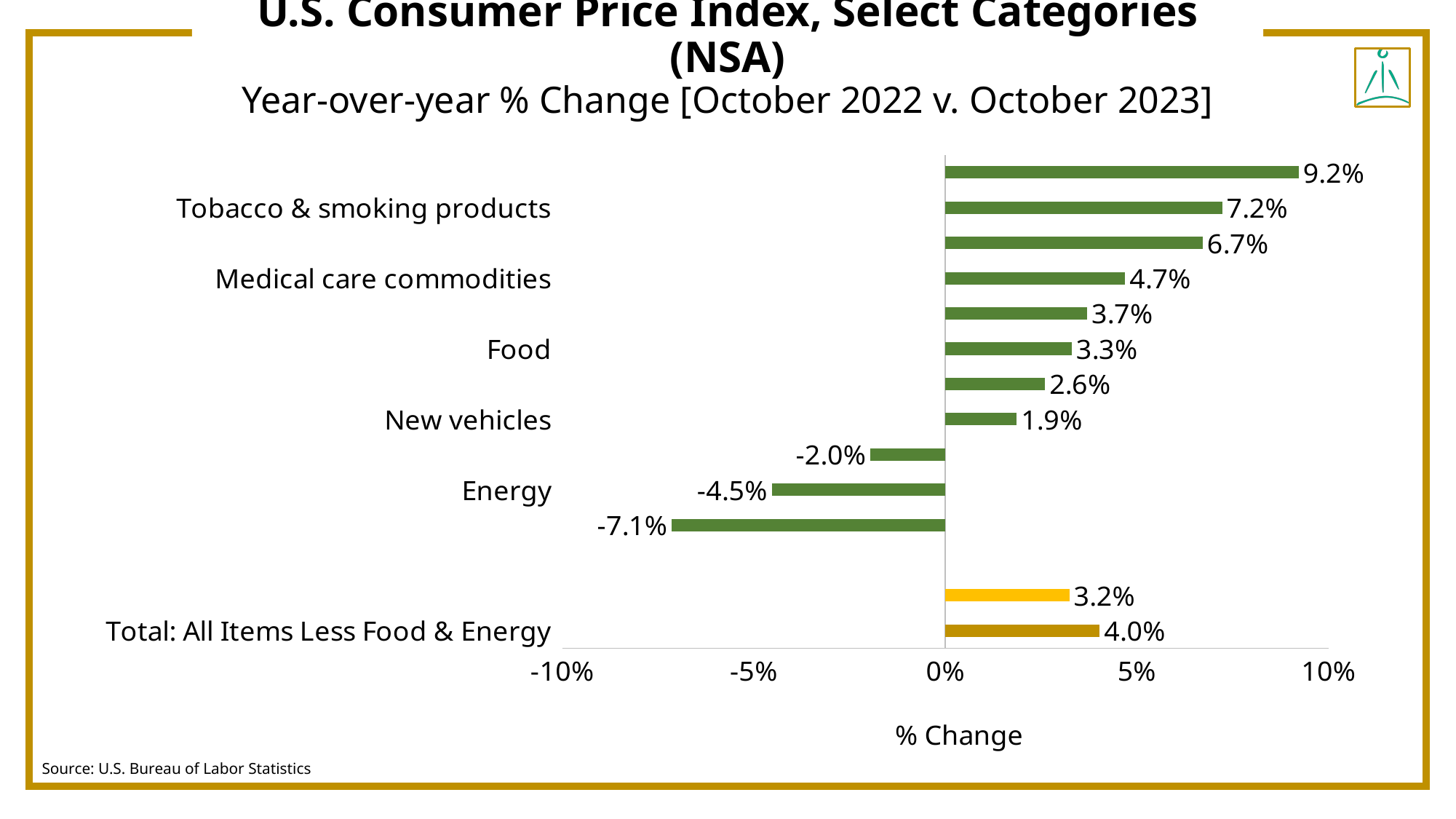
What is the year-over-year % change for New vehicles? 1.9% What is the year-over-year % change for Food? 3.3% What is the difference between the values for Tobacco & smoking products and Medical care commodities? 2.5 percentage points What is the value for Total: All Items Less Food & Energy? 4.0% What is the year-over-year % change for Energy? -4.5% What is the highest value plotted on the chart? 9.2% Which has a larger year-over-year % change, Food or New vehicles? Food What is the year-over-year % change for Medical care commodities? 4.7% What kind of chart is shown on the slide? Bar chart How many bars are plotted on the chart? 13 What is the year-over-year % change for Tobacco & smoking products? 7.2% What is the lowest value plotted on the chart? -7.1%